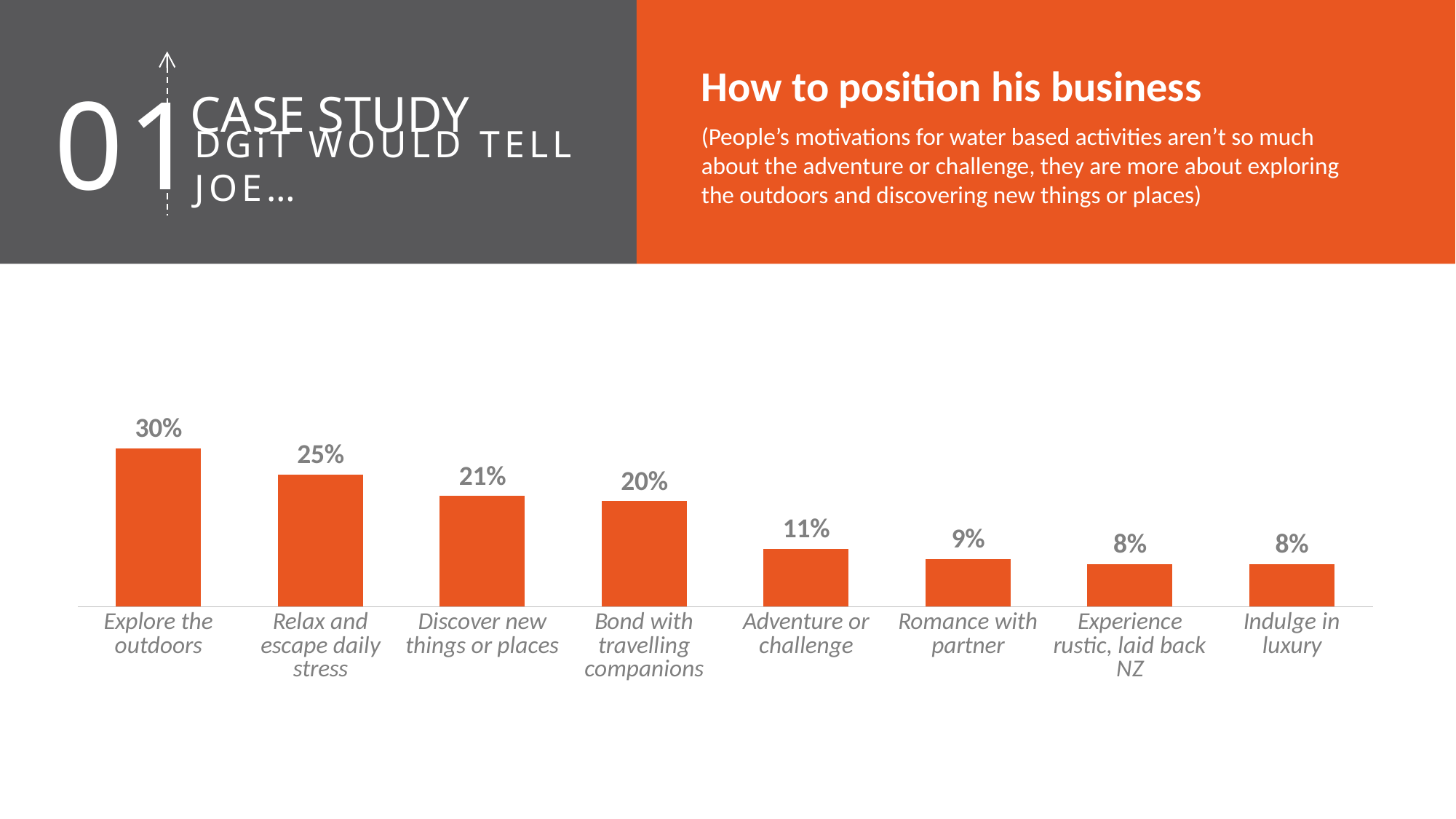
What is the value for Explore the outdoors? 30% What is the value for Adventure or challenge? 11% What colour are the bars in the chart? Orange What kind of chart is shown on the slide? Bar chart What is the difference between Explore the outdoors and Relax and escape daily stress? 5% How many categories are shown in the chart? 8 Which is larger, Relax and escape daily stress or Discover new things or places? Relax and escape daily stress What is the value for Romance with partner? 9% Which category has the highest value? Explore the outdoors What is the value for Bond with travelling companions? 20% Do the values rise or fall from left to right across the categories? Fall What is the difference between Discover new things or places and Adventure or challenge? 10%